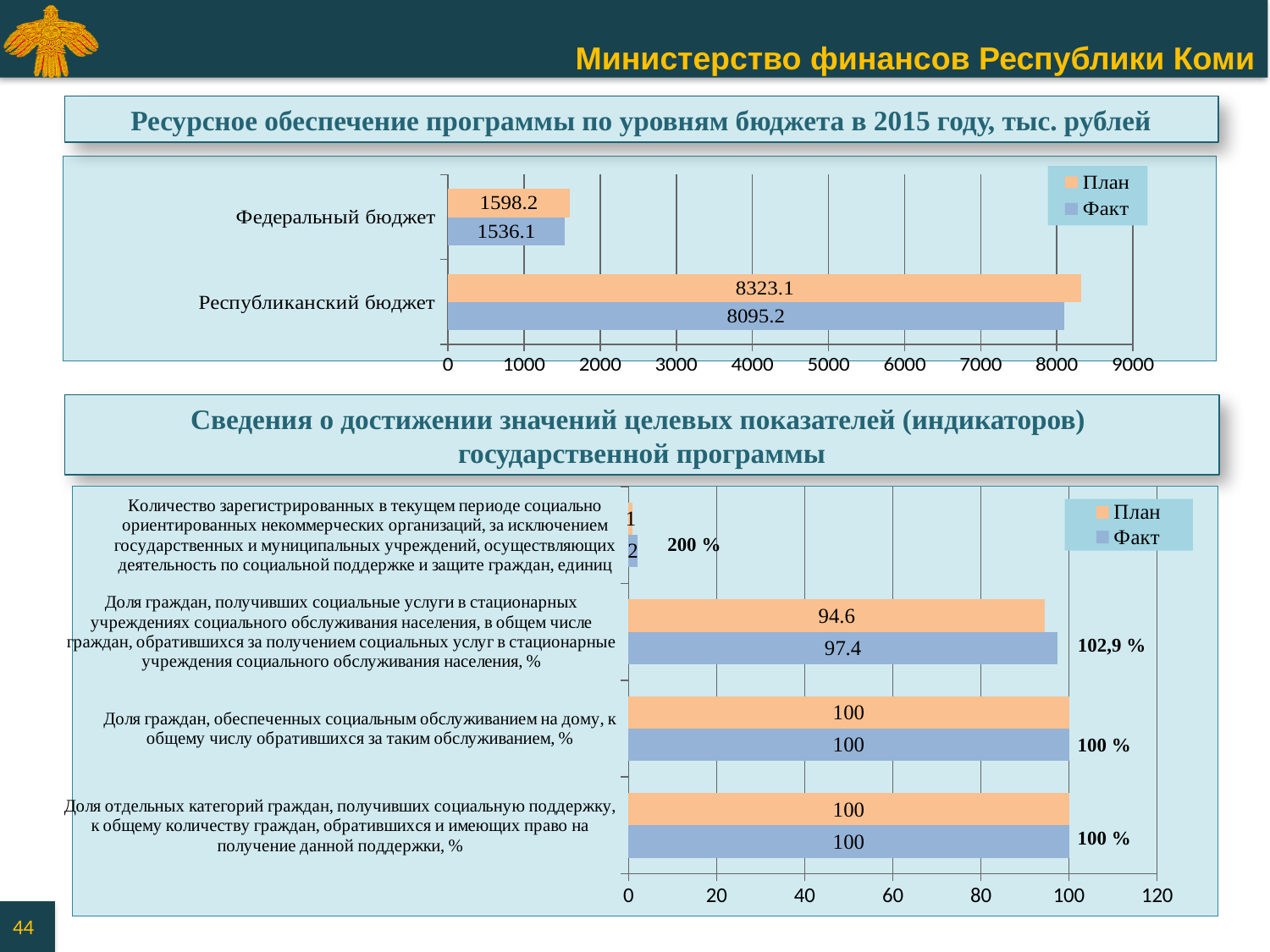
In the bottom chart 'Сведения о достижении значений целевых показателей', which is larger for 'Доля граждан, получивших социальные услуги в стационарных учреждениях', the План or the Факт value? Факт In the top chart 'Ресурсное обеспечение программы по уровням бюджета в 2015 году', what is the Факт value for Федеральный бюджет? 1536.1 In the top chart 'Ресурсное обеспечение программы по уровням бюджета в 2015 году', which budget level has the higher Факт value? Республиканский бюджет In the bottom chart 'Сведения о достижении значений целевых показателей', how many indicator categories are shown? 4 In the bottom chart 'Сведения о достижении значений целевых показателей', what is the Факт value for 'Доля граждан, получивших социальные услуги в стационарных учреждениях социального обслуживания населения'? 97.4 What kind of chart is the top chart 'Ресурсное обеспечение программы по уровням бюджета в 2015 году'? bar chart In the bottom chart 'Сведения о достижении значений целевых показателей', what is the План value for 'Доля граждан, получивших социальные услуги в стационарных учреждениях социального обслуживания населения'? 94.6 In the top chart 'Ресурсное обеспечение программы по уровням бюджета в 2015 году', how many series does the legend list? 2 In the top chart 'Ресурсное обеспечение программы по уровням бюджета в 2015 году', what is the План value for Республиканский бюджет? 8323.1 In the top chart 'Ресурсное обеспечение программы по уровням бюджета в 2015 году', is the План value for Федеральный бюджет greater or less than 2000? less In the bottom chart 'Сведения о достижении значений целевых показателей', what is the Факт value for 'Доля граждан, обеспеченных социальным обслуживанием на дому'? 100 In the top chart 'Ресурсное обеспечение программы по уровням бюджета в 2015 году', what is the difference between the План and Факт values for Республиканский бюджет? 227.9